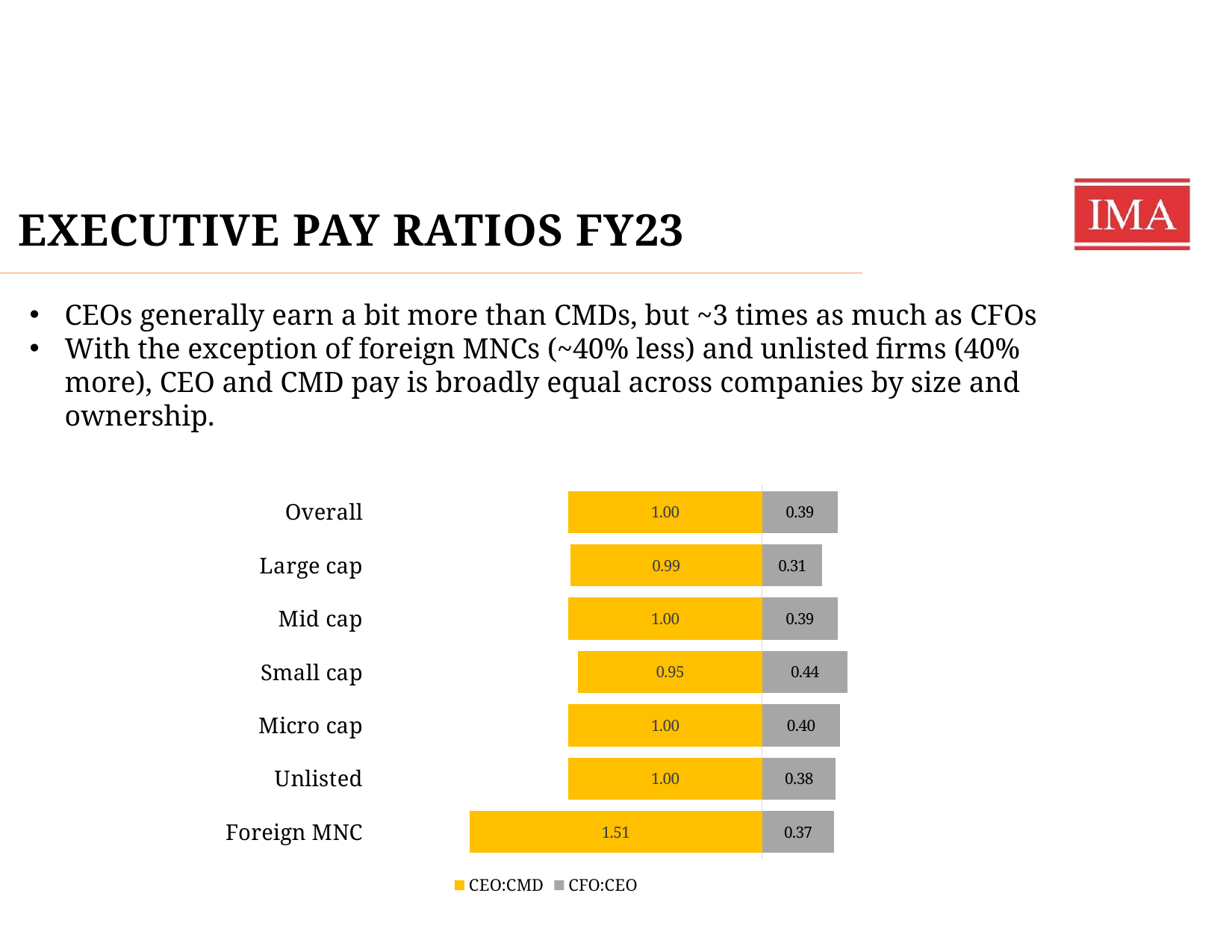
How many series does the legend list? 2 What is the CEO:CMD value for Foreign MNC? 1.51 What is the difference between the CEO:CMD values for Foreign MNC and Overall? 0.51 Which is larger, the CFO:CEO value for Small cap or for Large cap? Small cap How many categories are shown on the chart? 7 What is the CFO:CEO value for Small cap? 0.44 What kind of chart is shown on the slide? Bar chart What is the CFO:CEO value for Large cap? 0.31 Which category has the lowest CFO:CEO value? Large cap Which category has the highest CEO:CMD value? Foreign MNC What is the CEO:CMD value for Small cap? 0.95 Which category has the highest CFO:CEO value? Small cap